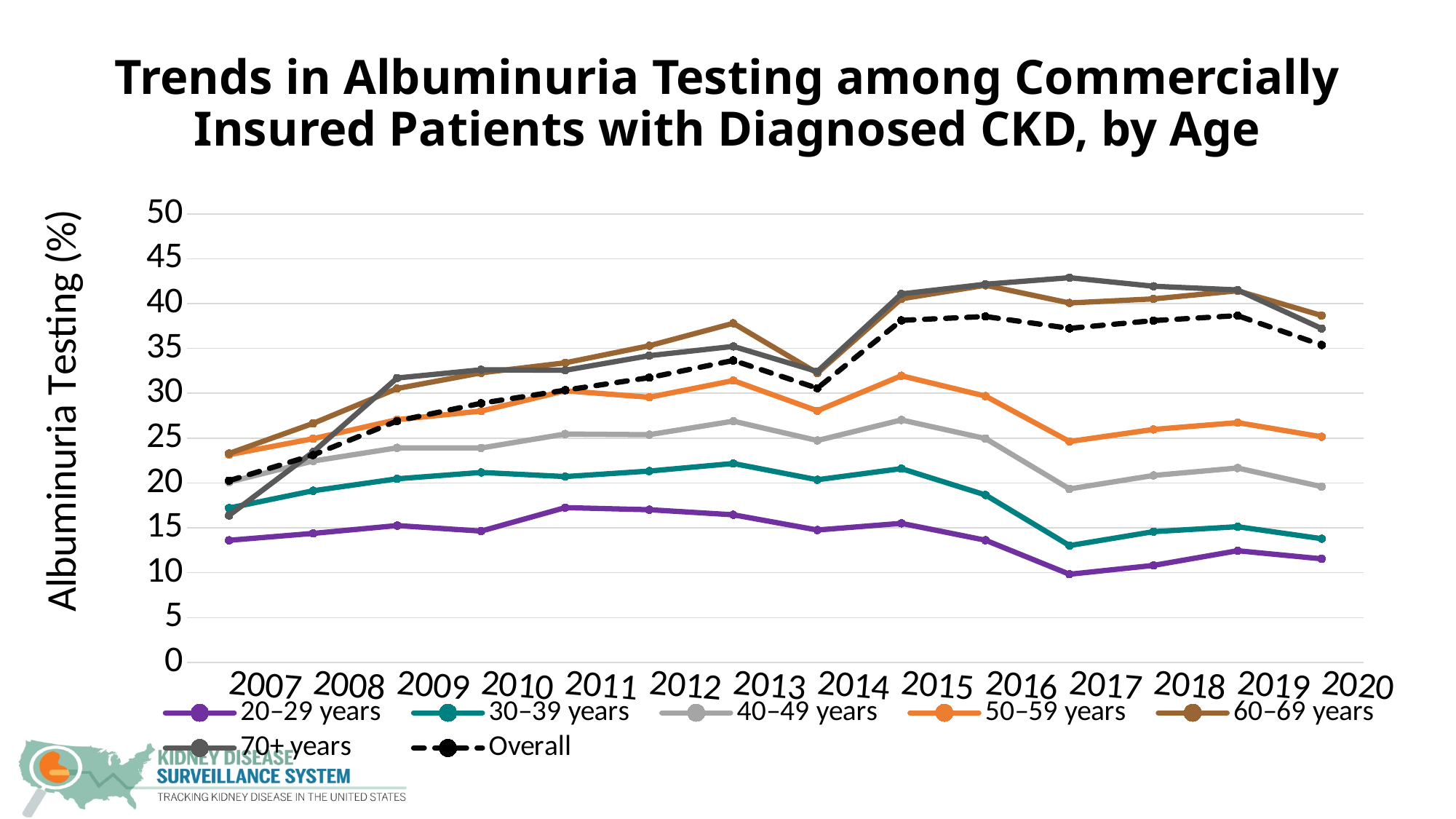
What is the label of the y axis? Albuminuria Testing (%) How many series does the legend list? 7 Is the value for 50–59 years in 2015 greater or less than 30? greater Is the value for 40–49 years in 2017 greater or less than 20? less Is the value for 70+ years in 2017 greater or less than 40? greater How many years are shown along the x axis? 14 In 2015, which is larger: the value for 50–59 years or the value for 40–49 years? 50–59 years Which age group has the highest albuminuria testing percentage in 2017? 70+ years Which age group has the lowest albuminuria testing percentage in 2020? 20–29 years What kind of chart is shown on the slide? Line chart